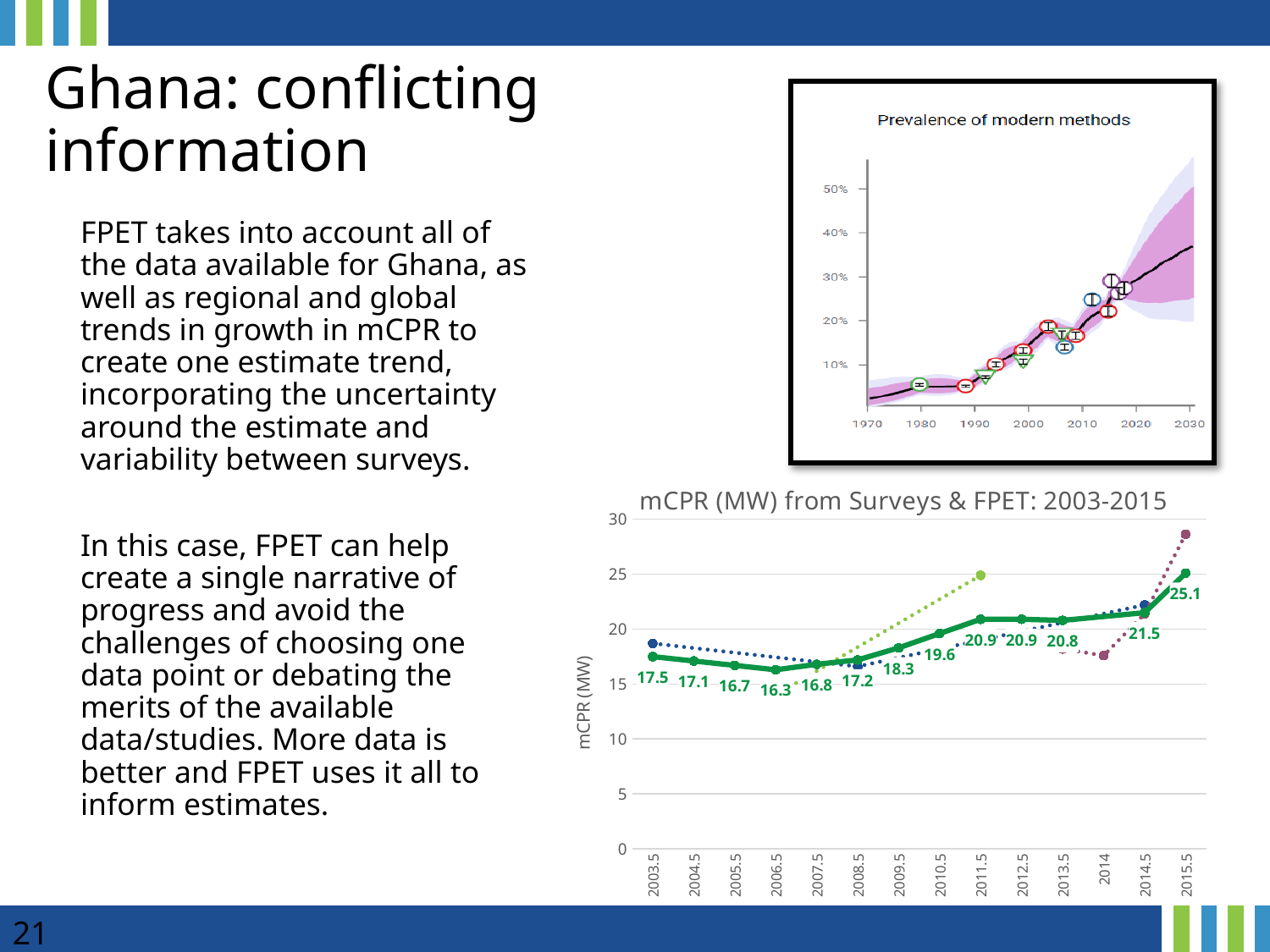
On the bottom chart, what is the highest labelled value on the solid green line? 25.1 On the bottom chart, does the solid green line rise or fall between 2008.5 and 2015.5? rise On the bottom chart, what is the labelled value of the solid green line at 2010.5? 19.6 On the bottom chart, what is the label on the vertical axis? mCPR (MW) On the bottom chart, is the value of the purple dotted line at 2015.5 greater or less than 25? greater On the bottom chart, what is the difference between the solid green line's labelled values at 2015.5 and 2014.5? 3.6 On the bottom chart, what kind of chart is it? line chart On the bottom chart, which is larger on the solid green line: the value at 2003.5 or the value at 2006.5? 2003.5 On the bottom chart, at which x-axis point does the solid green line reach its lowest labelled value? 2006.5 On the bottom chart, what is the labelled value of the solid green line at 2003.5? 17.5 On the bottom chart, what is the title? mCPR (MW) from Surveys & FPET: 2003-2015 On the bottom chart, what is the labelled value of the solid green line at 2015.5? 25.1